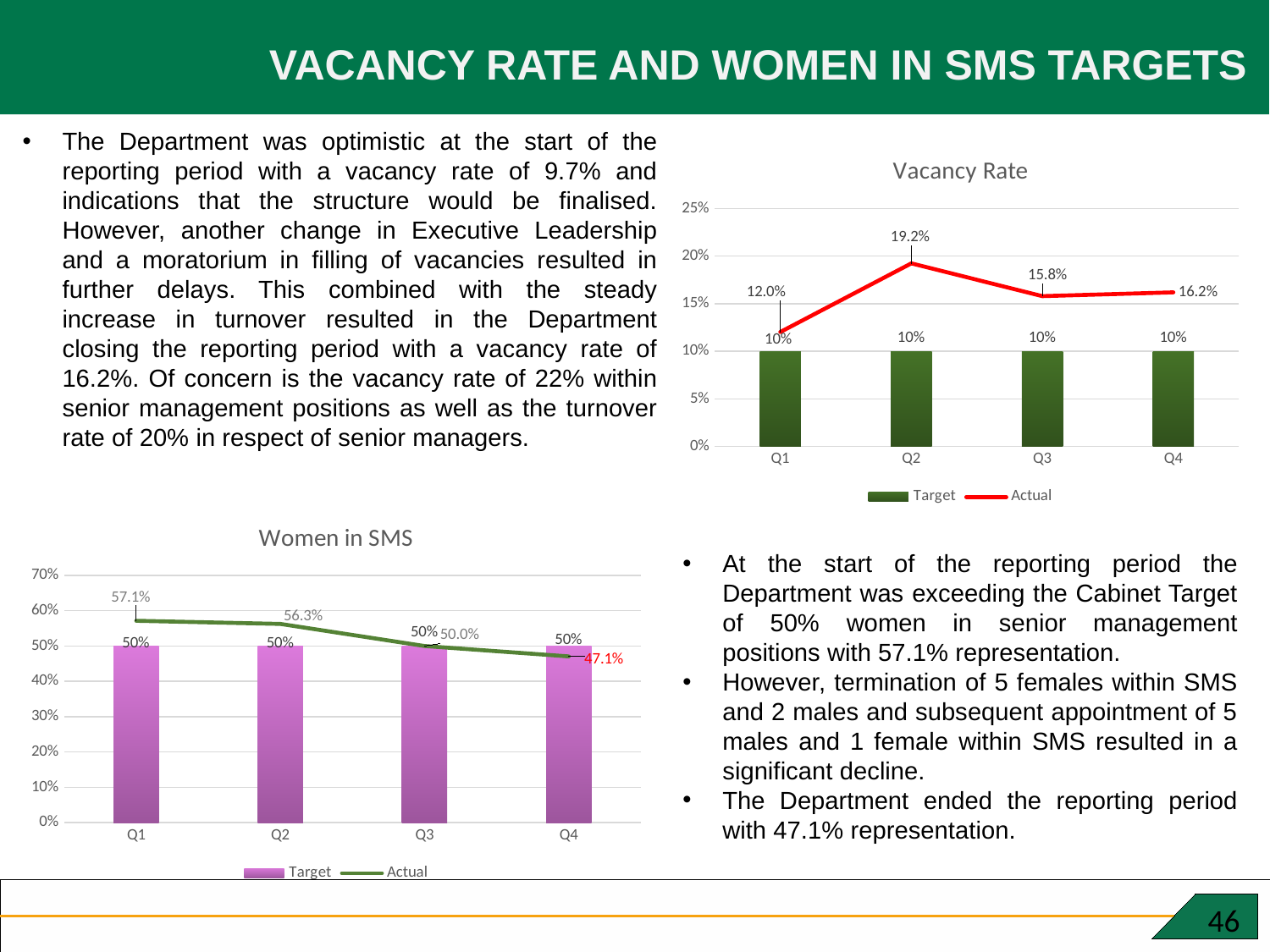
In the Women in SMS chart, how many quarters are shown on the x axis? 4 In the Vacancy Rate chart, what is the difference between the Actual vacancy rate in Q2 and the Target in Q2? 9.2% In the Vacancy Rate chart, what is the Actual vacancy rate in Q4? 16.2% In the Women in SMS chart, what is the Actual value in Q1? 57.1% In the Women in SMS chart, which is larger in Q2, the Target or the Actual value? Actual In the Vacancy Rate chart, which quarter has the lowest Actual vacancy rate? Q1 In the Women in SMS chart, what is the Actual value in Q4? 47.1% In the Women in SMS chart, does the Actual line rise or fall from Q1 to Q4? fall In the Women in SMS chart, what colour are the Target bars? Purple In the Vacancy Rate chart, which quarter has the highest Actual vacancy rate? Q2 In the Vacancy Rate chart, what is the Actual vacancy rate in Q2? 19.2% In the Vacancy Rate chart, how many series does the legend list? 2